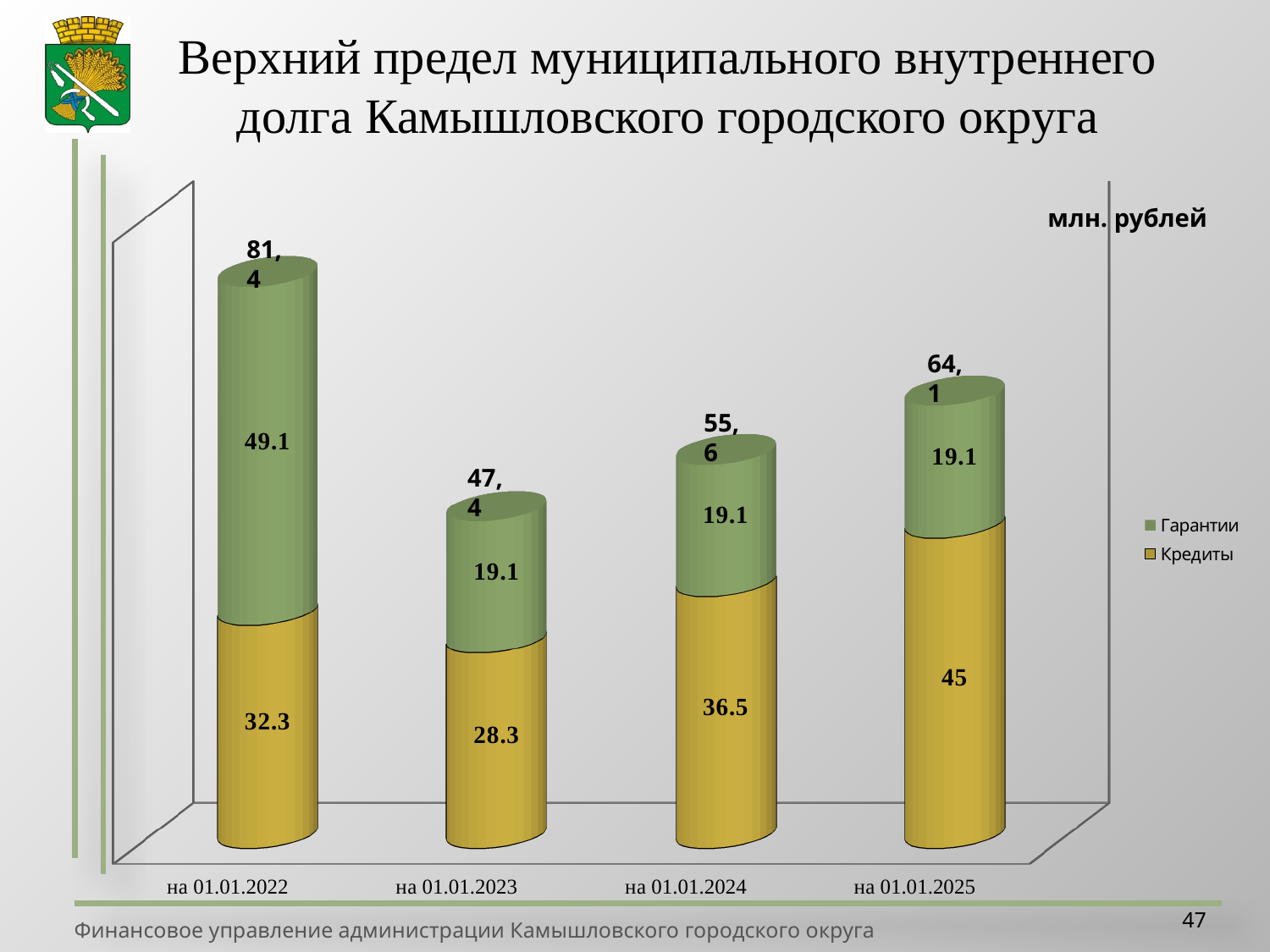
How many categories are shown on the x axis? 4 Which date has the lowest value for Кредиты? на 01.01.2023 What is the value for Кредиты on 01.01.2025? 45 What is the value for Кредиты on 01.01.2022? 32.3 Which is larger: Гарантии on 01.01.2022 or Гарантии on 01.01.2023? Гарантии on 01.01.2022 What is the value for Гарантии on 01.01.2024? 19.1 What is the value for Гарантии on 01.01.2022? 49.1 Which date has the highest value for Кредиты? на 01.01.2025 What is the total of the stacked bar for 01.01.2023? 47,4 What is the difference between the Кредиты values on 01.01.2025 and 01.01.2024? 8.5 What is the total of the stacked bar for 01.01.2022? 81,4 How many series does the legend list? 2